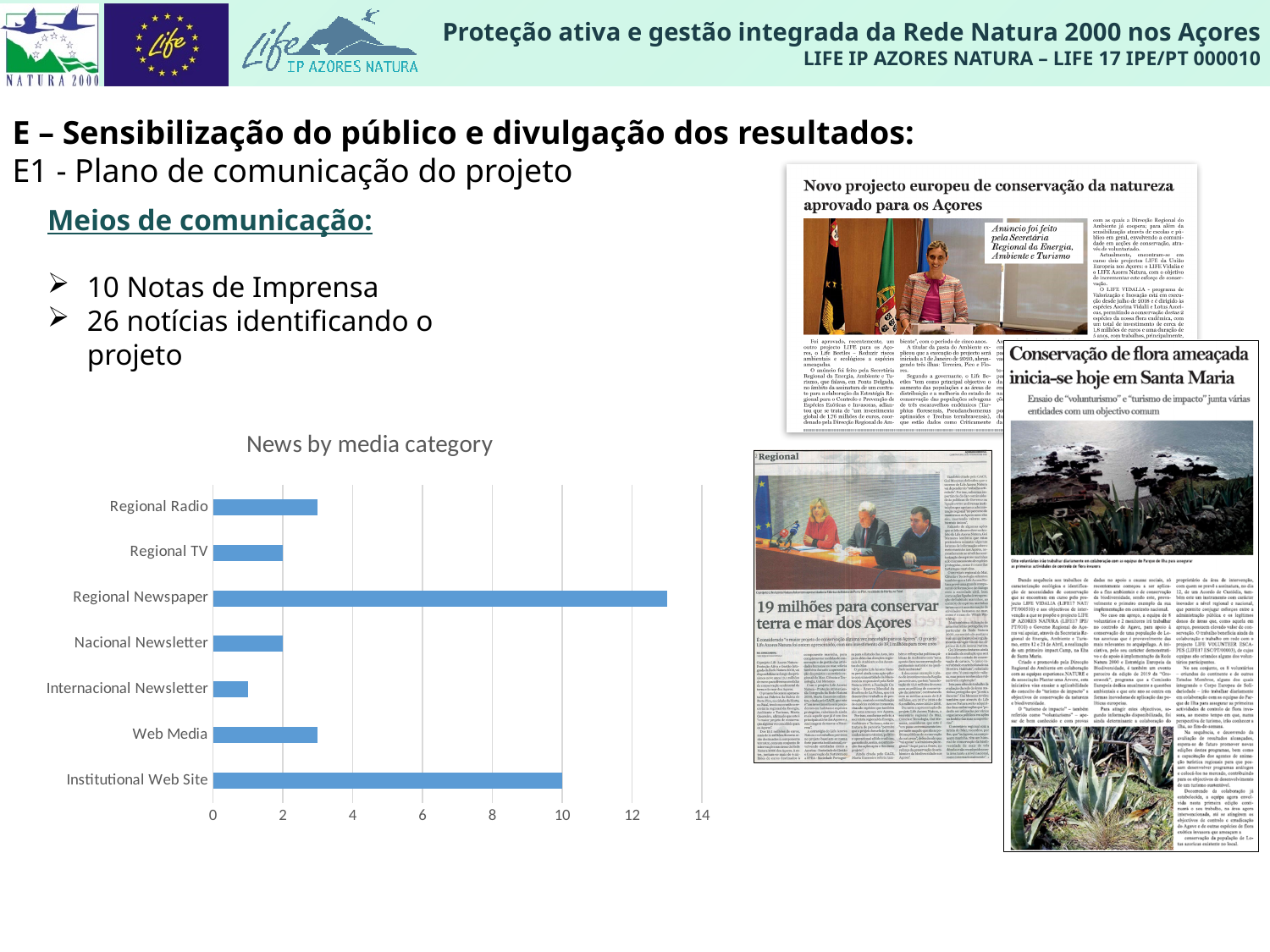
What is the value for Institutional Web Site? 10 Which has more news items, Institutional Web Site or Web Media? Institutional Web Site Is the value for Regional Newspaper greater or less than 12? greater What is the title of the chart on the slide? News by media category What is the value for Nacional Newsletter? 2 Which media category has the highest number of news items? Regional Newspaper Is the value for Web Media greater or less than 4? less Which media category has the lowest number of news items? Internacional Newsletter How many media categories are shown in the chart? 7 What type of chart is shown on the slide? bar chart Is the value for Internacional Newsletter greater or less than 2? less What is the value for Regional TV? 2